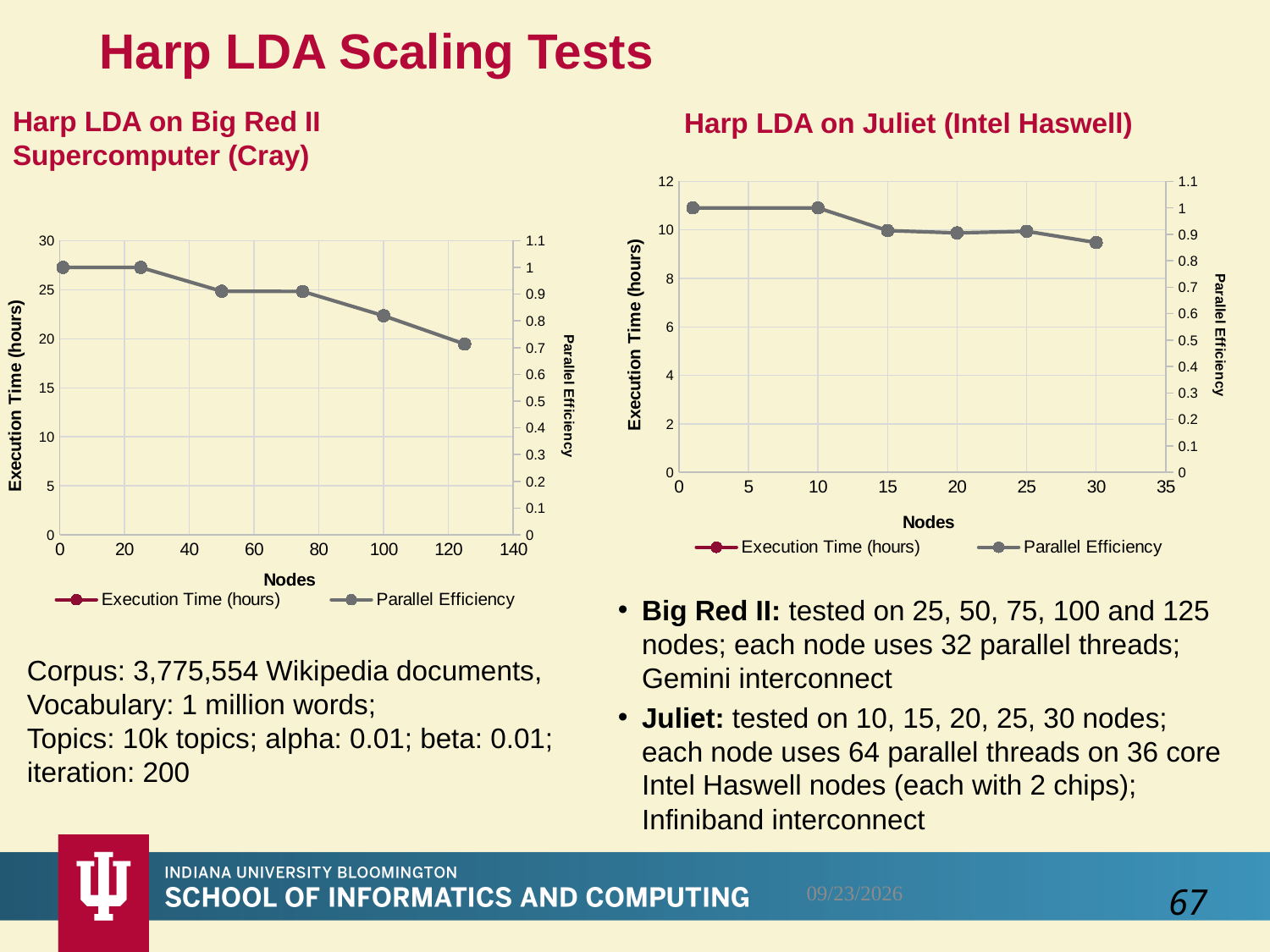
In the 'Harp LDA on Big Red II Supercomputer (Cray)' chart, at which number of nodes is the Parallel Efficiency lowest? 125 In the 'Harp LDA on Juliet (Intel Haswell)' chart, is the Parallel Efficiency at 30 nodes greater or less than 0.8? greater What type of chart is the 'Harp LDA on Big Red II Supercomputer (Cray)' chart? Line chart In the 'Harp LDA on Big Red II Supercomputer (Cray)' chart, is the Parallel Efficiency at 50 nodes greater or less than 0.8? greater In the 'Harp LDA on Big Red II Supercomputer (Cray)' chart, does the Parallel Efficiency line rise or fall as the number of nodes increases? Fall In the 'Harp LDA on Juliet (Intel Haswell)' chart, is the Parallel Efficiency at 10 nodes greater or less than 0.9? greater In the 'Harp LDA on Big Red II Supercomputer (Cray)' chart, is the Parallel Efficiency higher at 50 nodes or at 125 nodes? 50 nodes How many series does the legend of the 'Harp LDA on Juliet (Intel Haswell)' chart list? 2 What is the label of the right-hand (secondary) y axis on the 'Harp LDA on Big Red II Supercomputer (Cray)' chart? Parallel Efficiency What is the label of the x axis on the 'Harp LDA on Juliet (Intel Haswell)' chart? Nodes In the 'Harp LDA on Juliet (Intel Haswell)' chart, is the Parallel Efficiency higher at 10 nodes or at 30 nodes? 10 nodes